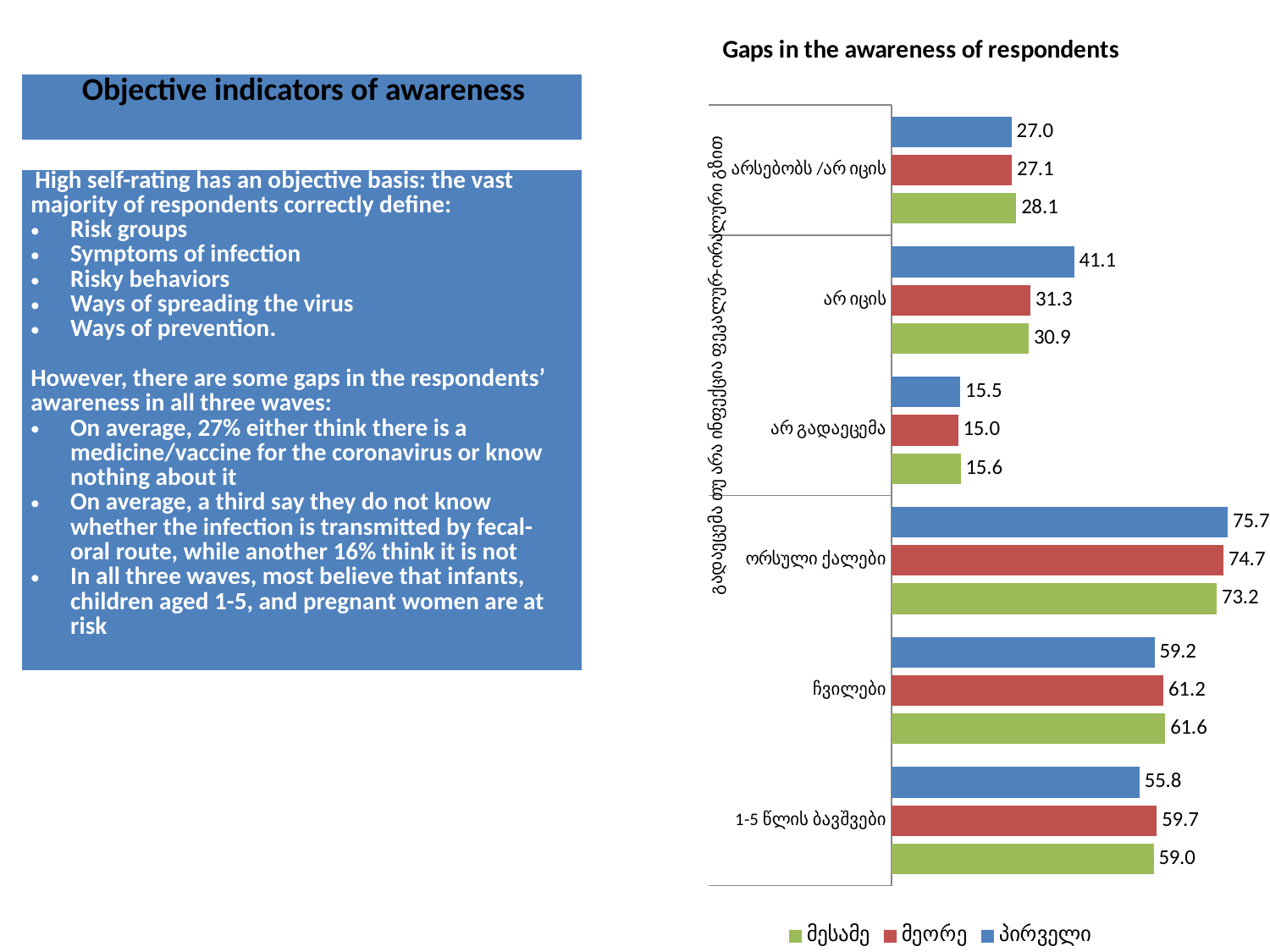
Which category has the highest value in the პირველი series? ორსული ქალები What is the value of the პირველი series for ორსული ქალები? 75.7 Which category has the lowest value in the მეორე series? არ გადაეცემა What is the difference between the მესამე and პირველი values for 1-5 წლის ბავშვები? 3.2 For ჩვილები, which series has the larger value: პირველი or მესამე? მესამე How many categories are shown on the "Gaps in the awareness of respondents" chart? 6 What is the difference between the პირველი and მეორე values for არ იცის? 9.8 What is the value of the მეორე series for 1-5 წლის ბავშვები? 59.7 What is the value of the მესამე series for არ იცის? 30.9 How many series does the legend of the "Gaps in the awareness of respondents" chart list? 3 What kind of chart is shown under the title "Gaps in the awareness of respondents"? bar chart Which colour represents the მეორე series in the chart? red